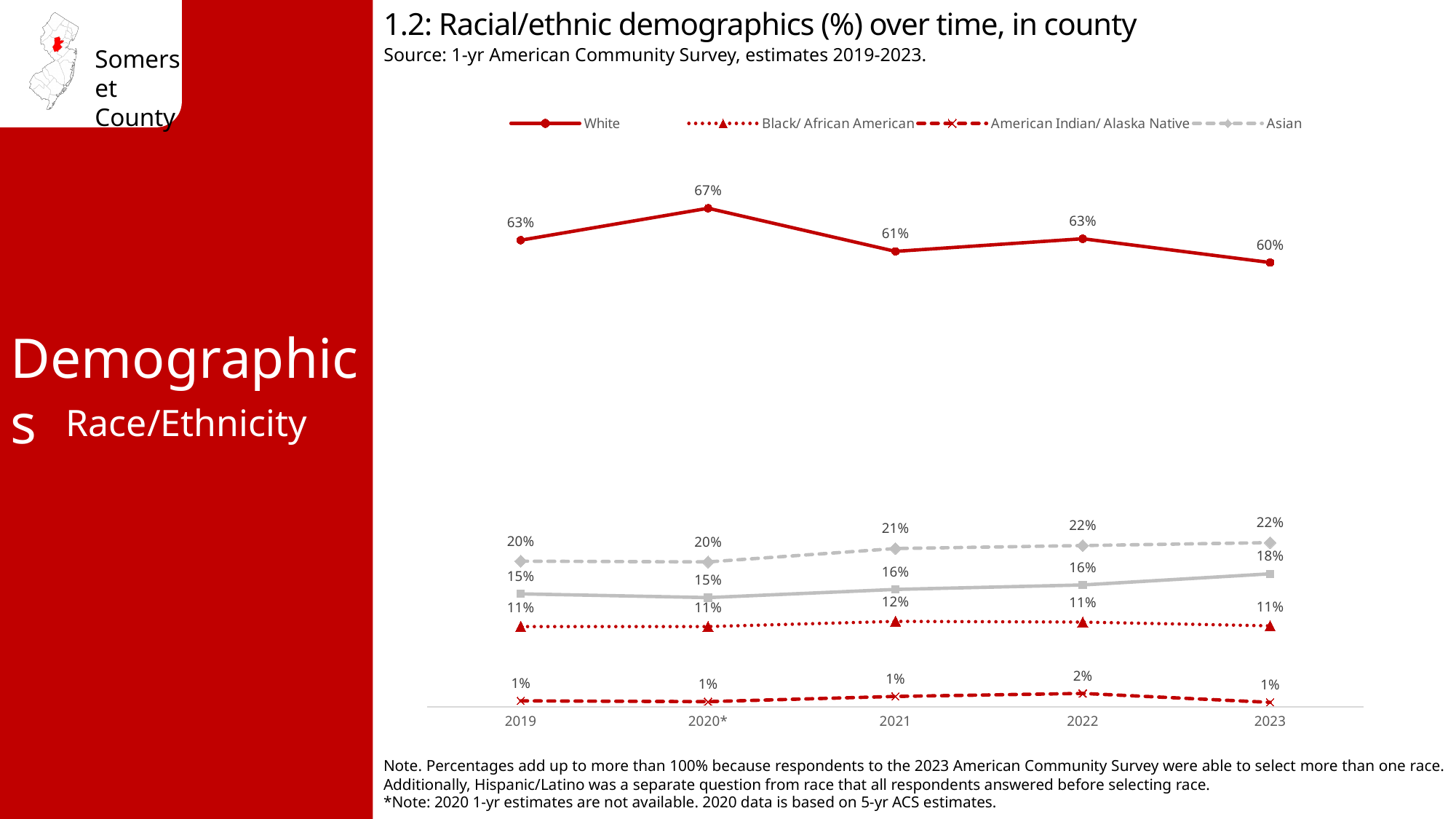
What was the American Indian/ Alaska Native percentage in 2022? 2% How many series does the legend list? 4 What was the Black/ African American percentage in 2021? 12% What was the White percentage in 2020*? 67% How many years are shown on the x axis? 5 What was the Asian percentage in 2023? 22% What kind of chart is shown on the slide? Line chart What is the difference between the White percentage in 2020* and in 2023? 7% Which was larger in 2019, the White percentage or the Asian percentage? White Did the Asian percentage rise or fall from 2019 to 2023? Rise In which year was the White percentage highest? 2020* In which year was the White percentage lowest? 2023